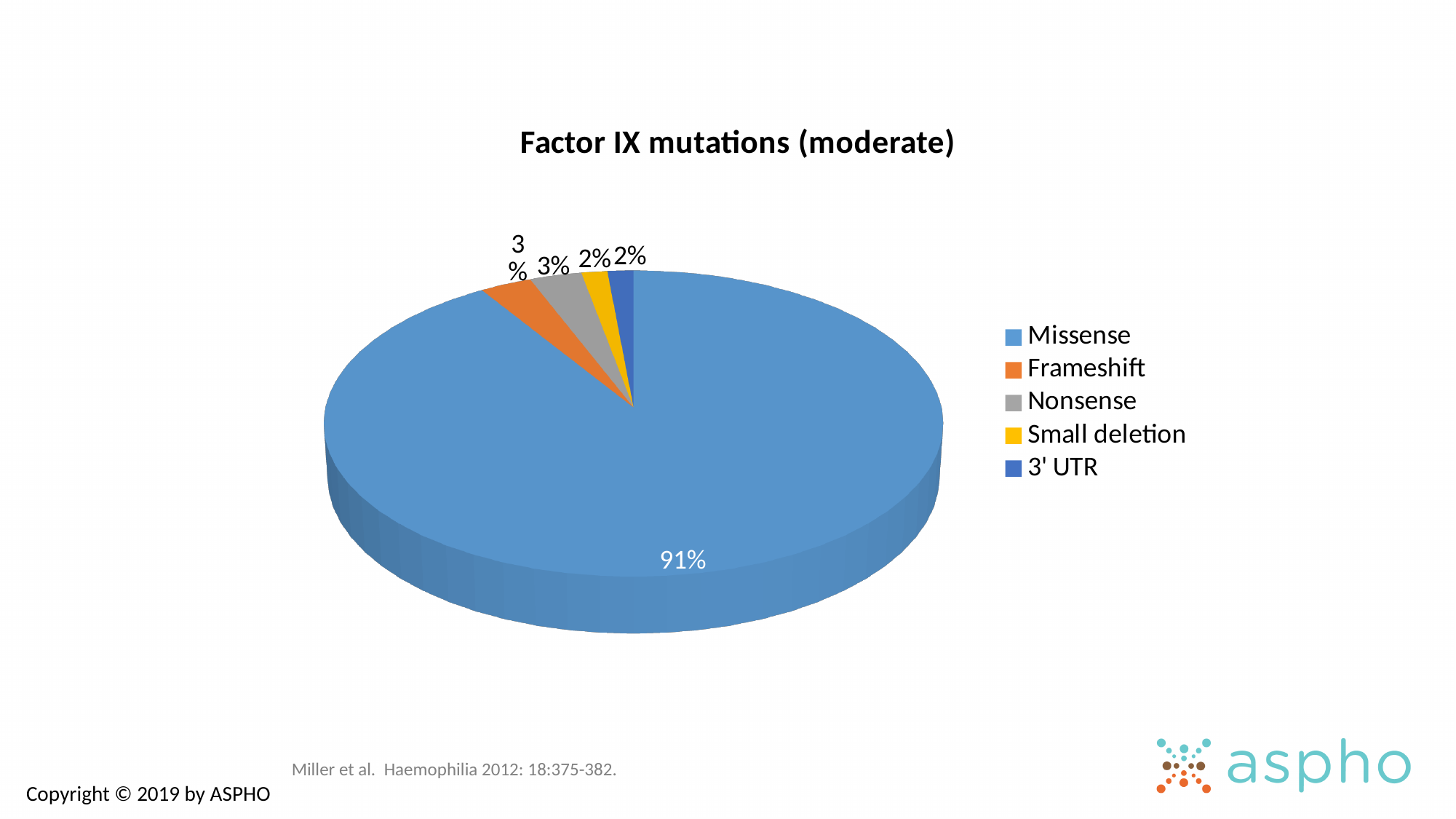
What percentage is shown for Small deletion? 2% How many categories does the pie chart show? 5 What is the difference in percentage points between Missense and Frameshift? 88 percentage points What kind of chart is shown on the slide? Pie chart What percentage of the pie does Missense account for? 91% What percentage is shown for Nonsense? 3% What percentage is shown for 3' UTR? 2% Which mutation type has the largest share of the pie? Missense What percentage is shown for Frameshift? 3% What is the title of the chart? Factor IX mutations (moderate) Which has a larger share, Frameshift or Small deletion? Frameshift Which category is shown in orange in the legend? Frameshift